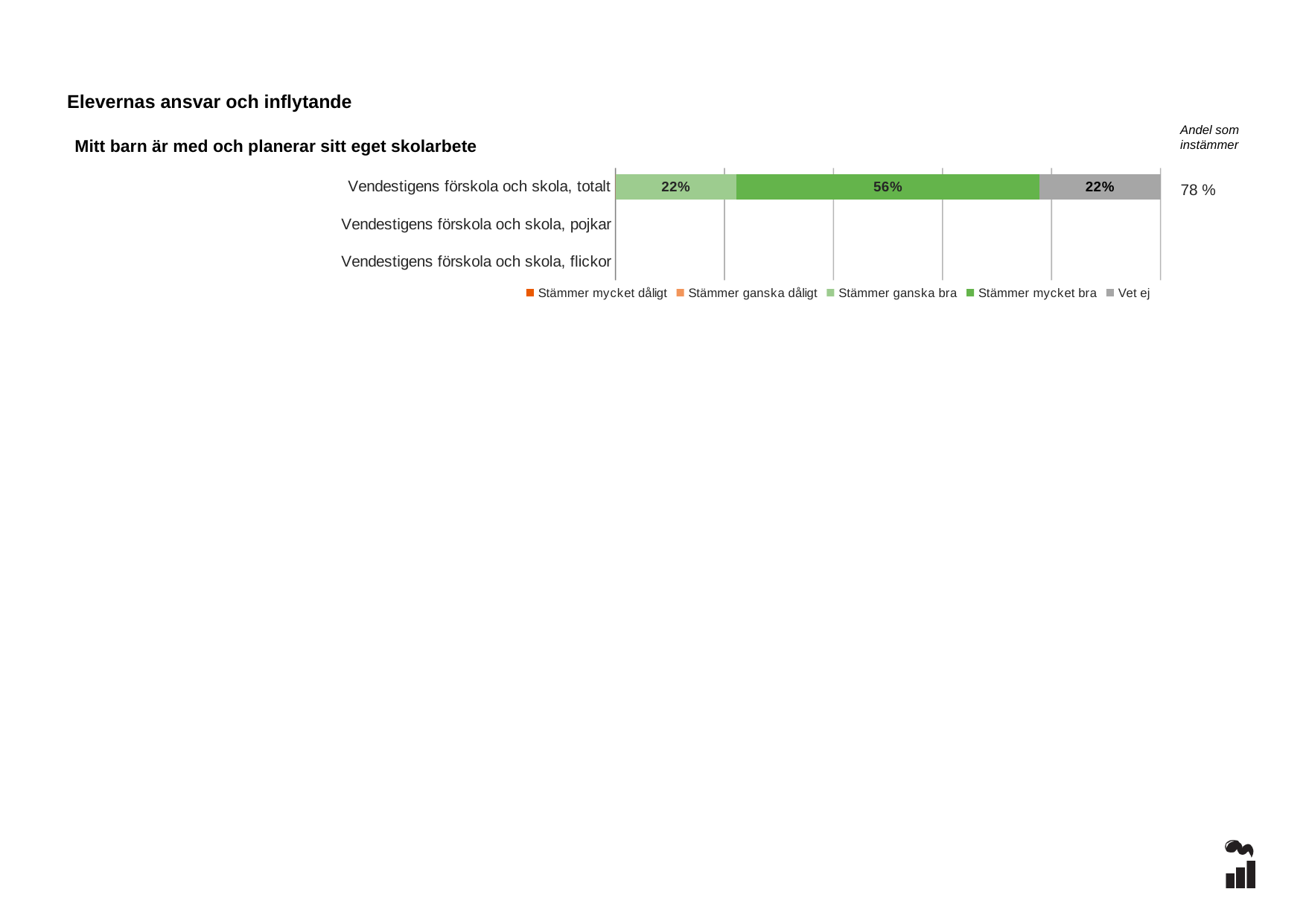
What is the value for 'Vet ej' for Vendestigens förskola och skola, totalt? 22% What is the total of the labelled segments in the bar for Vendestigens förskola och skola, totalt? 100% Which segment is the largest in the bar for Vendestigens förskola och skola, totalt? Stämmer mycket bra What is the difference between the 'Stämmer mycket bra' and 'Vet ej' values for Vendestigens förskola och skola, totalt? 34 percentage points What is the 'Andel som instämmer' value shown for Vendestigens förskola och skola, totalt? 78 % Which is larger for Vendestigens förskola och skola, totalt: 'Stämmer mycket bra' or 'Stämmer ganska bra'? Stämmer mycket bra What is the value for 'Stämmer mycket bra' for Vendestigens förskola och skola, totalt? 56% What is the value for 'Stämmer ganska bra' for Vendestigens förskola och skola, totalt? 22% How many category rows are listed on the y axis of the chart? 3 How many series does the legend list? 5 What kind of chart is shown on the slide? Stacked bar chart What is the title of the chart? Mitt barn är med och planerar sitt eget skolarbete